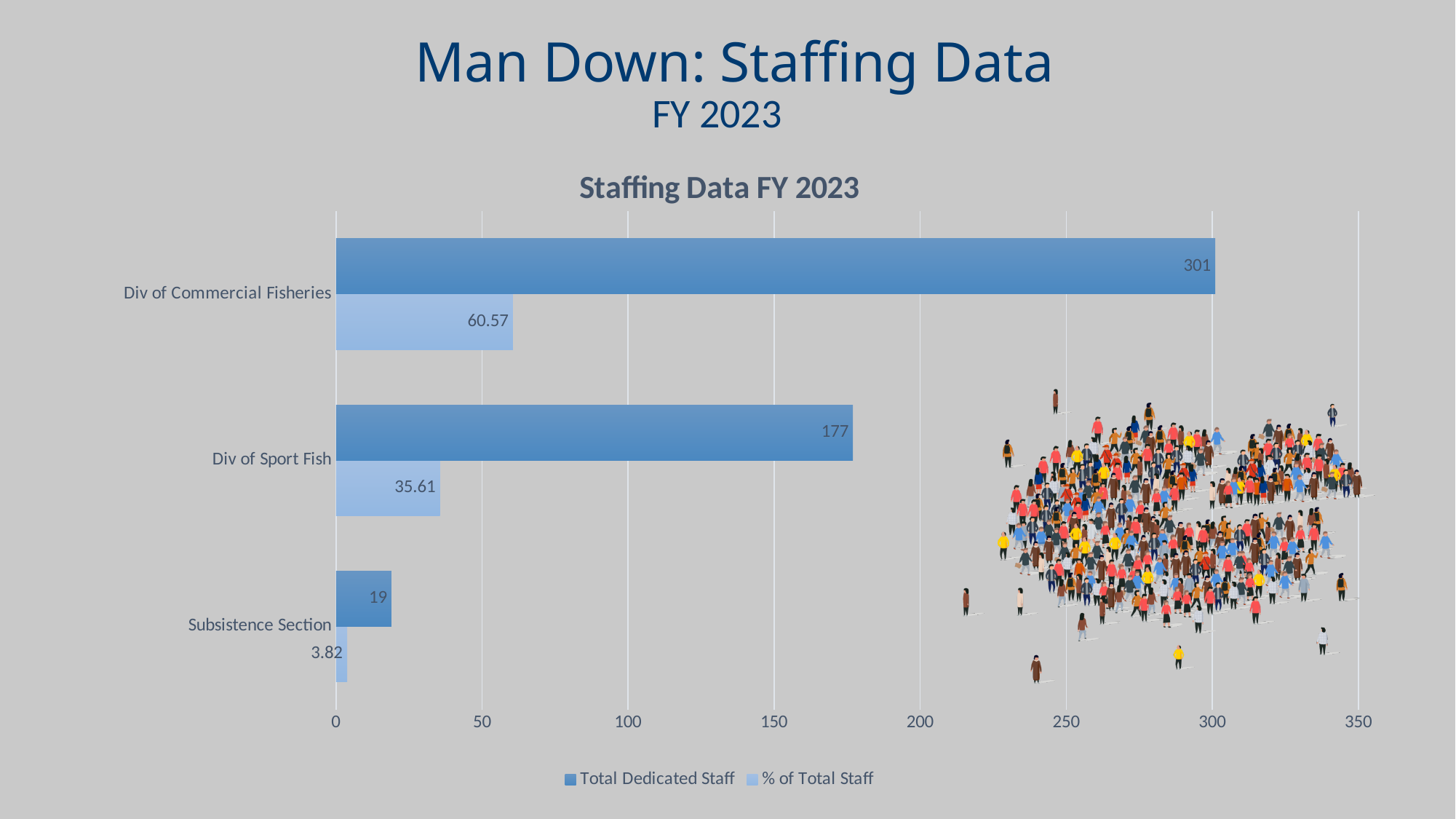
How many categories are shown on the chart? 3 Which category has the highest Total Dedicated Staff? Div of Commercial Fisheries What is the difference in Total Dedicated Staff between Div of Commercial Fisheries and Div of Sport Fish? 124 What is the % of Total Staff value for Div of Sport Fish? 35.61 How many series does the legend list? 2 What is the Total Dedicated Staff value for Div of Commercial Fisheries? 301 What kind of chart is shown on the slide? Bar chart Which category has the lowest % of Total Staff? Subsistence Section What is the Total Dedicated Staff value for Subsistence Section? 19 Which has a larger Total Dedicated Staff, Div of Sport Fish or Subsistence Section? Div of Sport Fish Is the Total Dedicated Staff value for Div of Sport Fish greater or less than 150? greater What is the % of Total Staff value for Div of Commercial Fisheries? 60.57